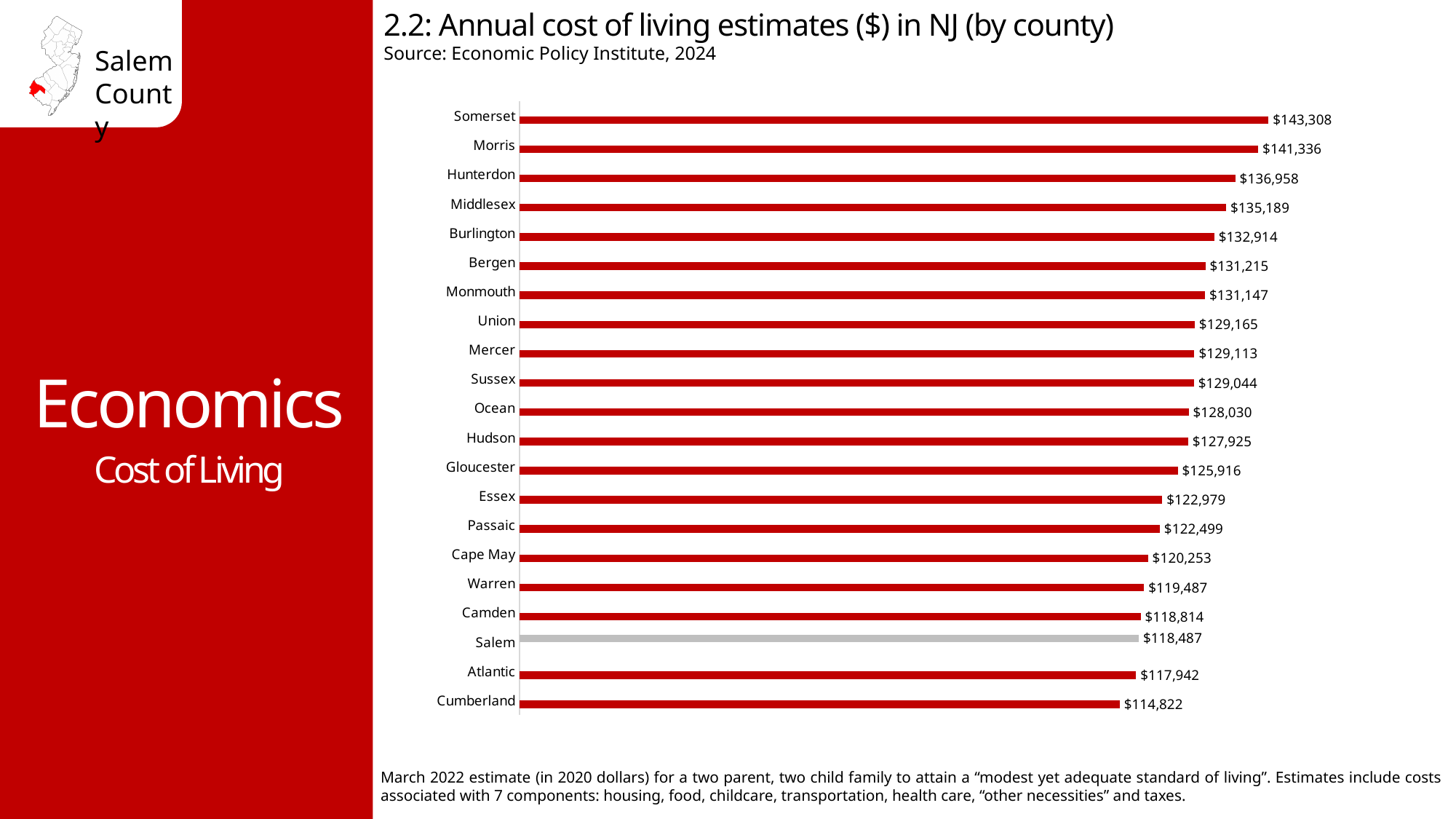
Which county's bar is shown in gray instead of red? Salem Which county has the highest annual cost of living estimate? Somerset What is the annual cost of living estimate for Salem County? $118,487 How many counties are shown in the chart? 21 Which has a higher cost of living estimate, Camden or Atlantic? Camden What is the difference between the cost of living estimates for Somerset and Cumberland? $28,486 What is the annual cost of living estimate for Somerset County? $143,308 What is the annual cost of living estimate for Gloucester County? $125,916 Which has a higher cost of living estimate, Morris or Hunterdon? Morris How much higher is Salem's cost of living estimate than Cumberland's? $3,665 What type of chart is used on this slide? Bar chart Which county has the lowest annual cost of living estimate? Cumberland